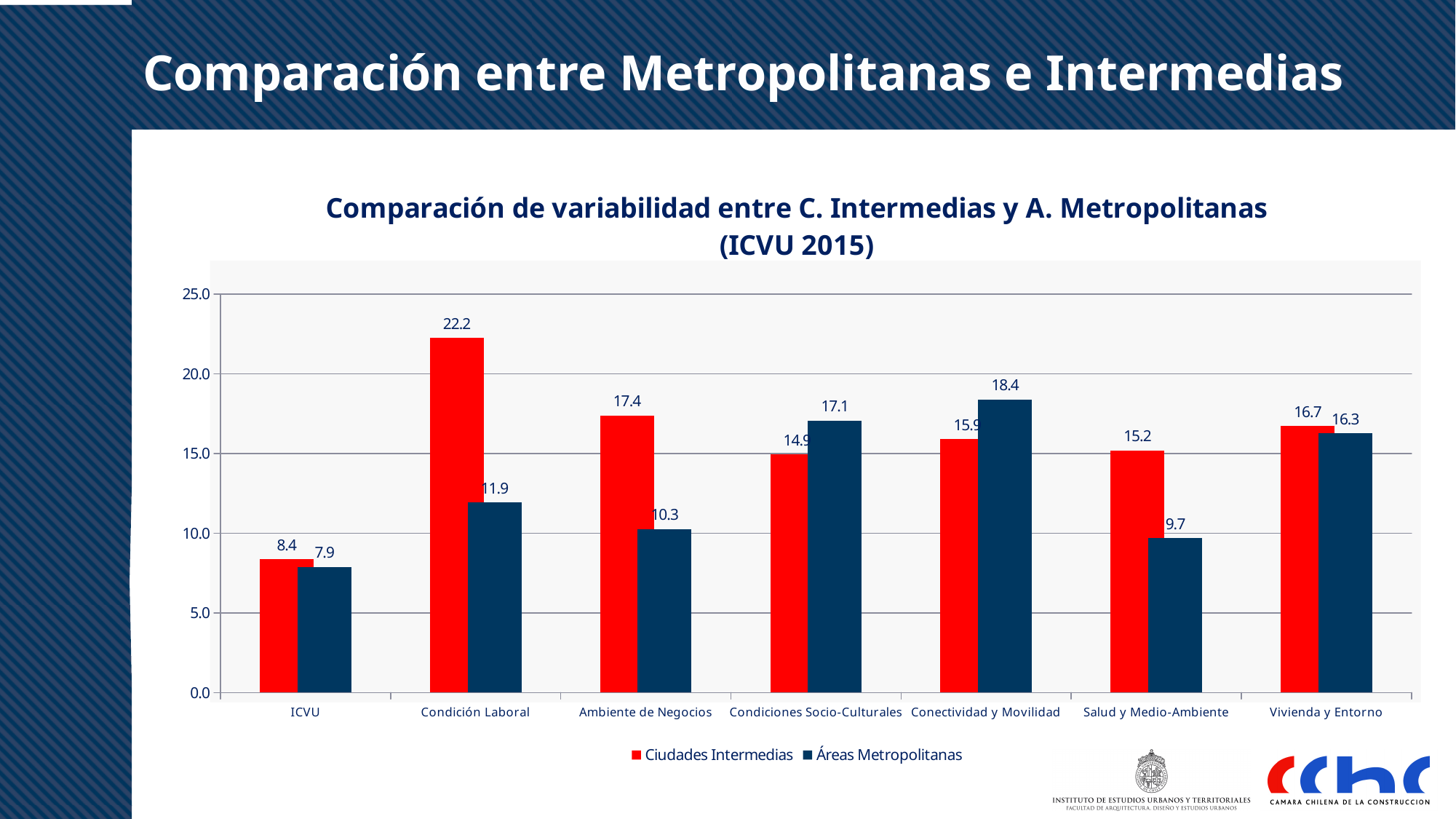
What is the value for Áreas Metropolitanas in the Conectividad y Movilidad category? 18.4 Is the value for Áreas Metropolitanas in Salud y Medio-Ambiente greater or less than 10.0? less In the Ambiente de Negocios category, which series has the larger value, Ciudades Intermedias or Áreas Metropolitanas? Ciudades Intermedias What kind of chart is shown on the slide? Bar chart Which colour represents Ciudades Intermedias in the chart? Red How many series does the legend list? 2 What is the value for Áreas Metropolitanas in the ICVU category? 7.9 Which category has the highest value for Ciudades Intermedias? Condición Laboral Which category has the lowest value for Áreas Metropolitanas? ICVU What is the value for Ciudades Intermedias in the Condición Laboral category? 22.2 How many categories are shown on the x axis? 7 What is the difference between Ciudades Intermedias and Áreas Metropolitanas in the Condición Laboral category? 10.3